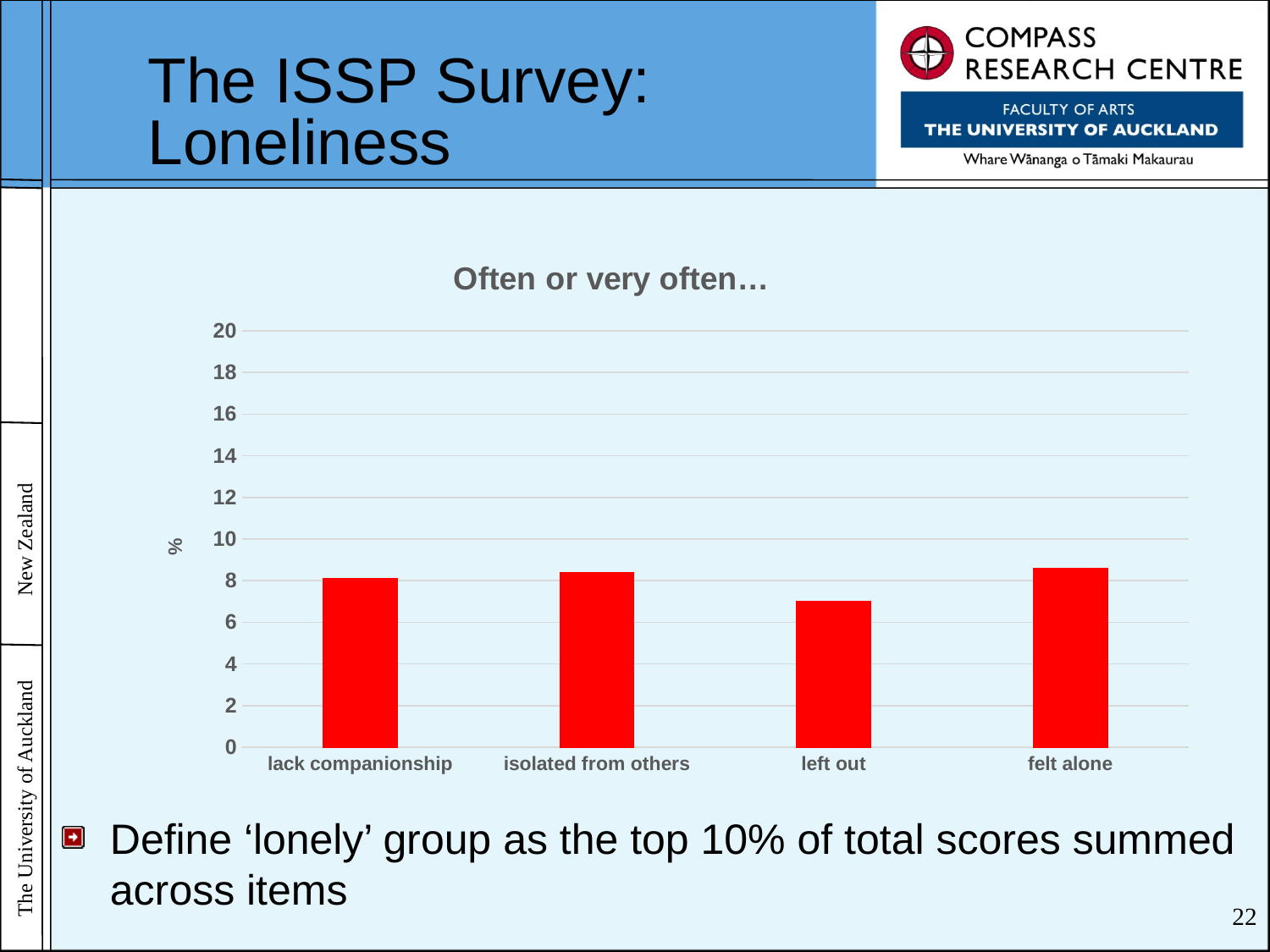
What kind of chart is shown on the slide? bar chart Which category has the lowest value in the chart? left out Is the value for 'left out' greater or less than 8? less What is the title of the chart? Often or very often… Is the value for 'isolated from others' greater or less than 10? less Is the value for 'left out' greater or less than 6? greater Which is larger, the value for 'lack companionship' or the value for 'left out'? lack companionship How many categories are shown in the chart? 4 What is the label on the vertical axis of the chart? % Which is larger, the value for 'felt alone' or the value for 'left out'? felt alone